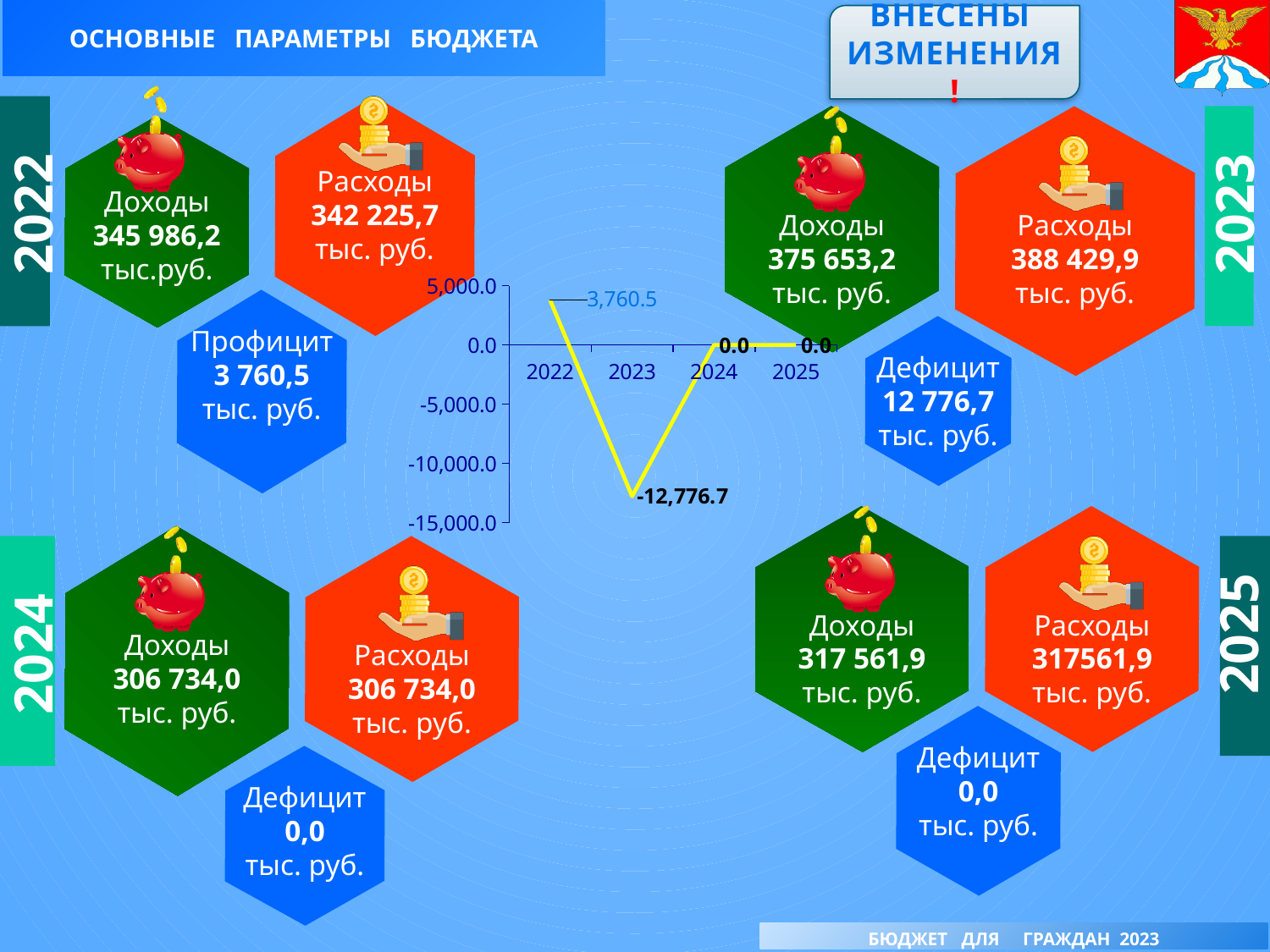
Does the line chart rise or fall from 2022 to 2023? fall Which year has the lowest value on the line chart? 2023 What is the value plotted for 2022 on the line chart? 3,760.5 What is the value plotted for 2024 on the line chart? 0.0 Is the value for 2023 on the line chart greater or less than -10,000.0? less How many years are plotted on the line chart? 4 Which is larger on the line chart, the value for 2022 or the value for 2023? 2022 What is the value plotted for 2025 on the line chart? 0.0 What is the value plotted for 2023 on the line chart? -12,776.7 Which year has the highest value on the line chart? 2022 What is the difference between the 2022 value and the 2023 value on the line chart? 16,537.2 What kind of chart is shown in the centre of the slide? line chart